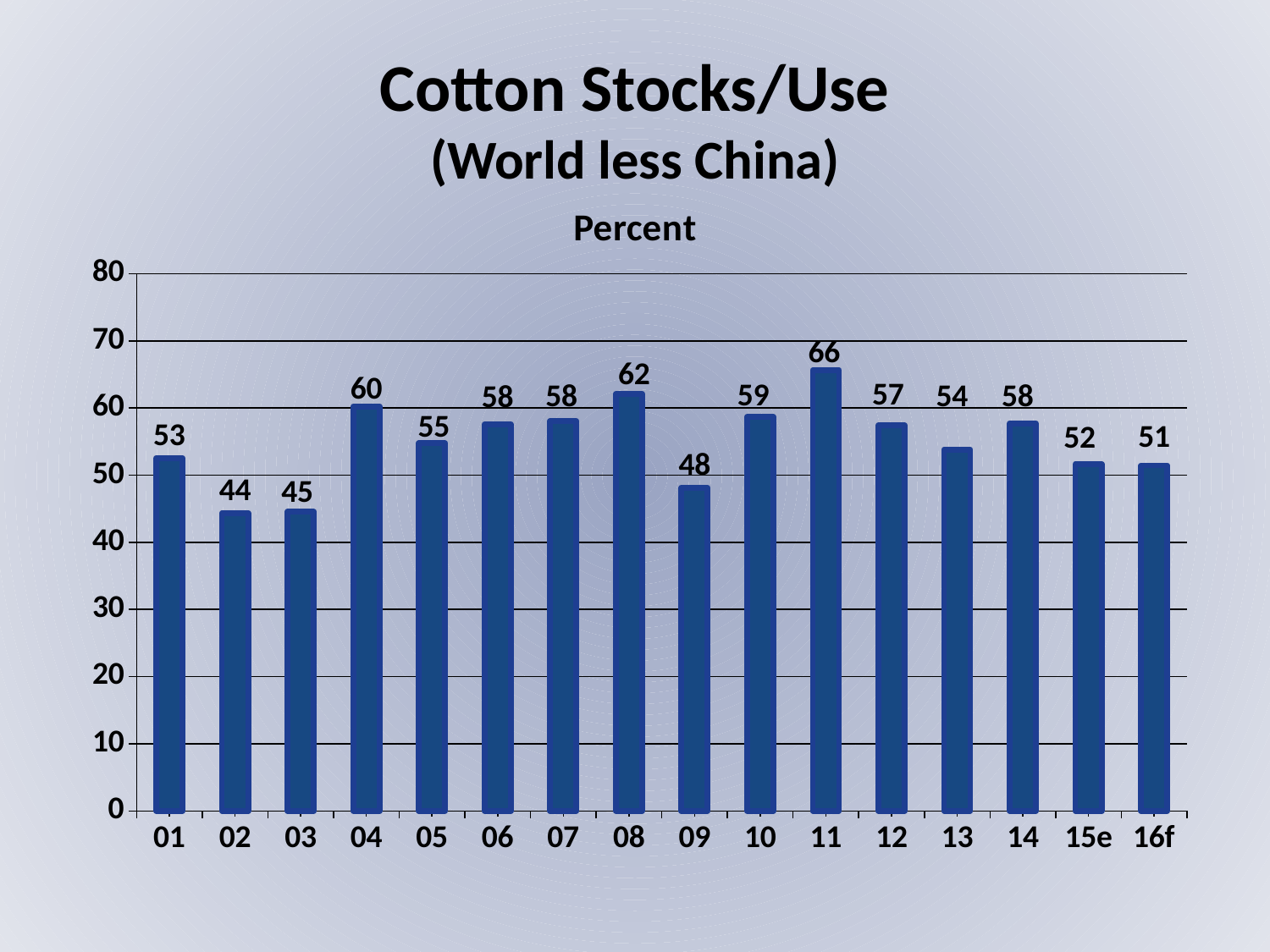
What is the value for 15e? 52 Which category has the highest value? 11 Is the value for 13 greater or less than 50? greater What kind of chart is this? bar chart How many categories are shown on the x axis? 16 What is the value for 11? 66 Which is larger, the value for 08 or the value for 10? 08 Which category has the lowest value? 02 What is the difference between the values for 04 and 03? 15 What is the title of the chart? Percent What is the value for 09? 48 What is the difference between the values for 11 and 09? 18